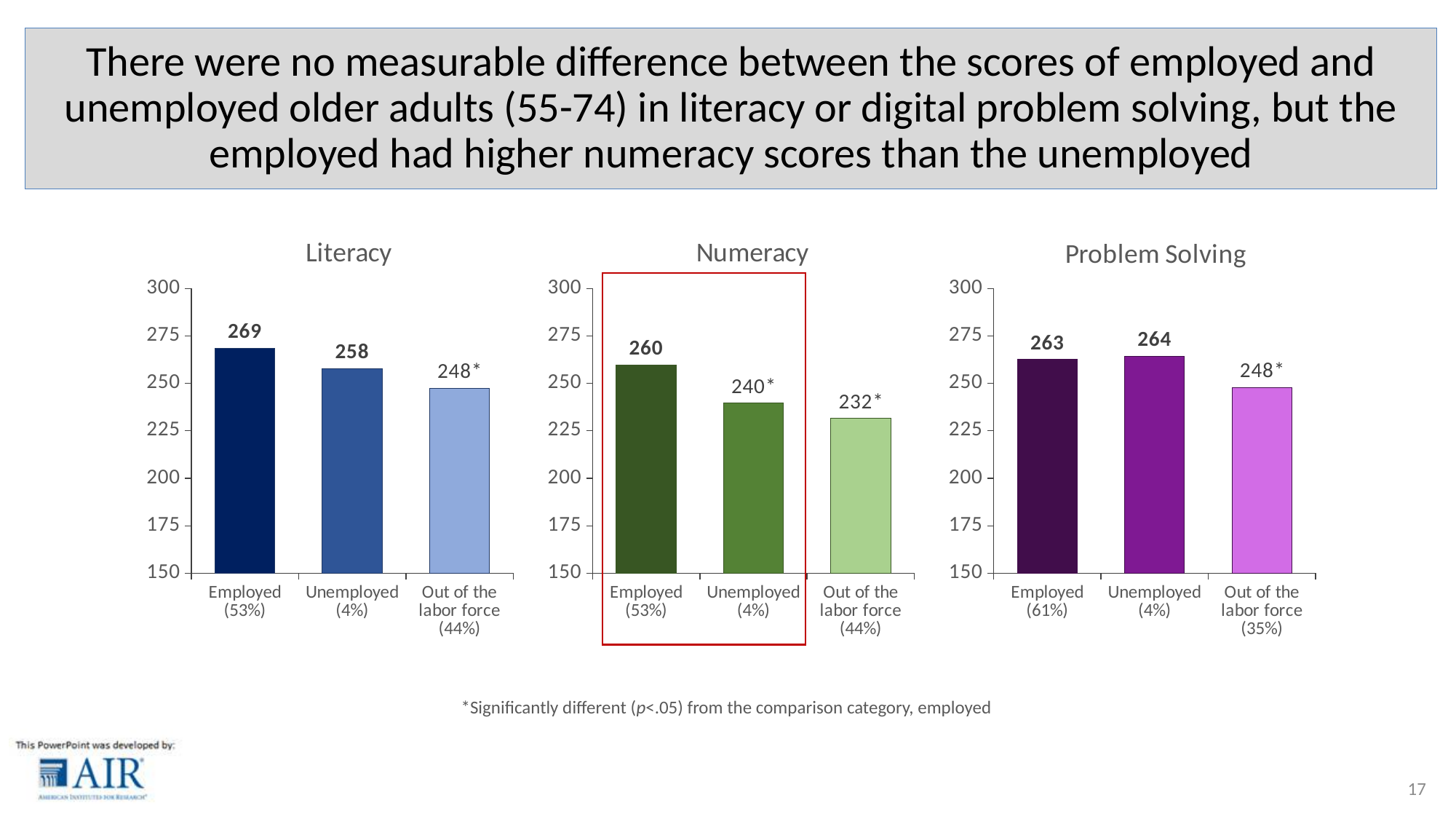
In the Numeracy chart, which is larger, the score for Employed or for Out of the labor force? Employed In the Literacy chart, what is the difference between the Employed and Out of the labor force scores? 21 In the Numeracy chart, which category has the lowest score? Out of the labor force (44%) In the Literacy chart, what is the score for Employed (53%)? 269 What kind of chart is the Literacy chart? bar chart In the Problem Solving chart, is the value for Out of the labor force greater or less than 250? less How many categories are shown in the Numeracy chart? 3 In the Numeracy chart, what is the difference between the Employed and Unemployed scores? 20 In the Numeracy chart, what is the score for Unemployed (4%)? 240 Which of the three charts is outlined with a red box? Numeracy In the Literacy chart, which category has the highest score? Employed (53%) In the Problem Solving chart, what is the score for Out of the labor force (35%)? 248